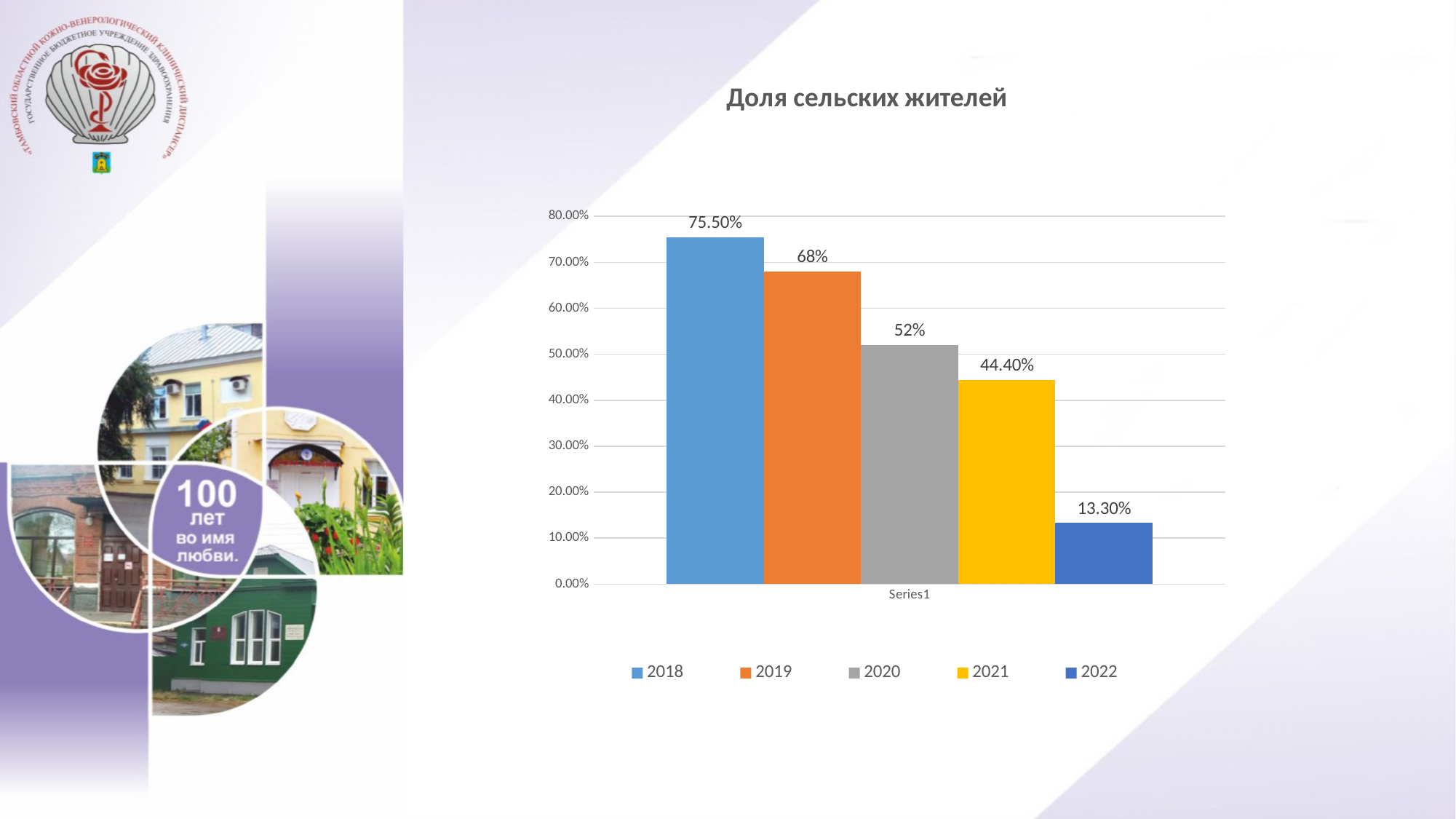
What is the title of the chart? Доля сельских жителей What is the value for 2018? 75.50% What kind of chart is shown? Bar chart How many series does the legend list? 5 What is the value for 2020? 52% What is the value for 2022? 13.30% Which year has the lowest value? 2022 What is the value for 2021? 44.40% What is the difference between the values for 2018 and 2019? 7.50% Which year has the highest value? 2018 Which is larger, the value for 2020 or the value for 2021? 2020 Do the values rise or fall from 2018 to 2022? Fall